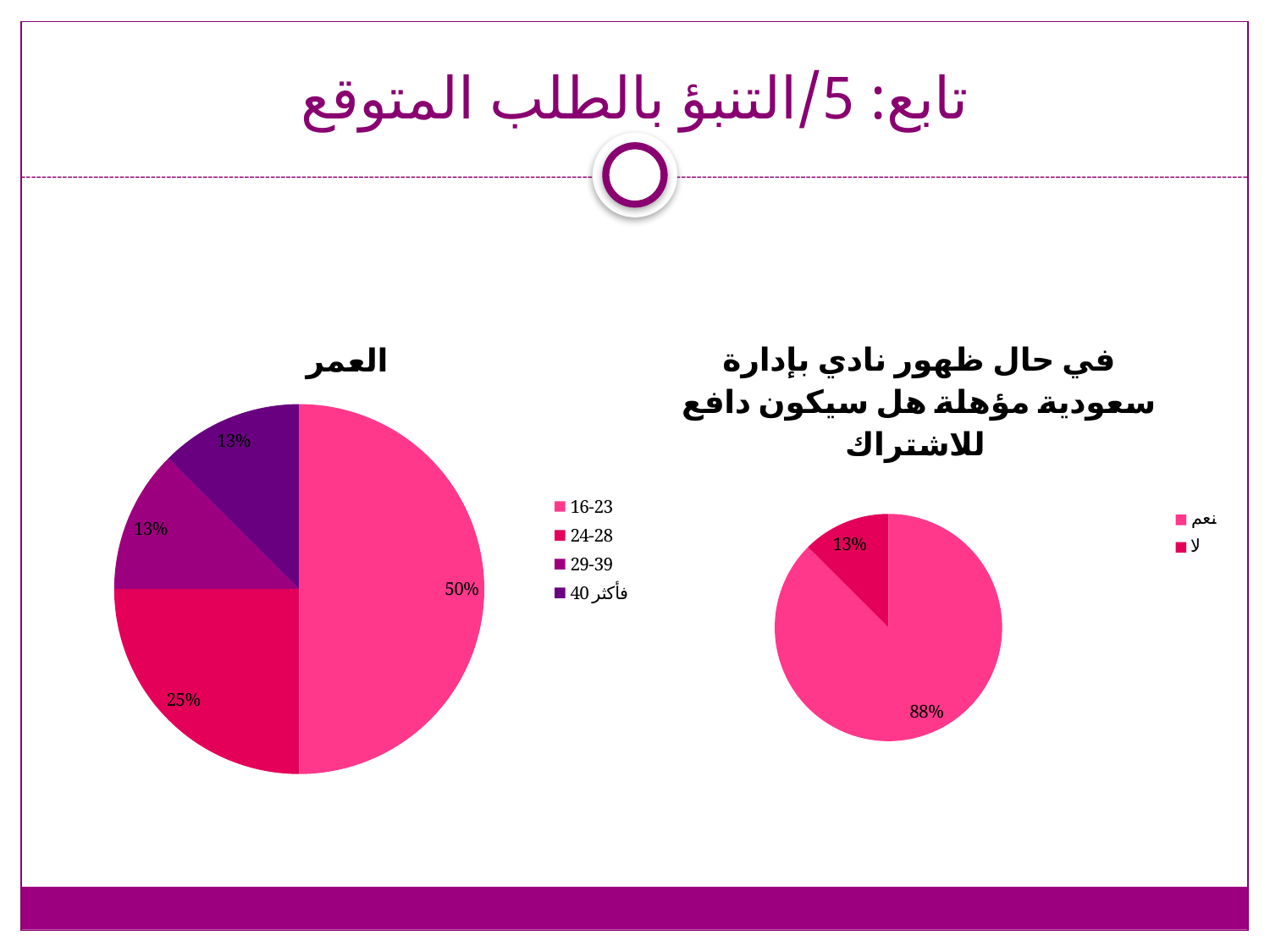
In the right-hand chart (في حال ظهور نادي بإدارة سعودية مؤهلة هل سيكون دافع للاشتراك), what share of the pie is "نعم"? 88% How many pie charts are shown on the slide? 2 In the right-hand chart (في حال ظهور نادي بإدارة سعودية مؤهلة هل سيكون دافع للاشتراك), what is the value for "لا"? 13% In the chart titled "العمر", which is larger, the 24-28 share or the 29-39 share? 24-28 In the chart titled "العمر", what is the difference between the 16-23 share and the 24-28 share? 25% In the chart titled "العمر", what share of the pie is the 16-23 category? 50% What kind of chart is the chart titled "العمر"? Pie chart In the chart titled "العمر", how many categories does the legend list? 4 In the chart titled "العمر", what is the value for the 24-28 category? 25% In the chart titled "العمر", which age category has the largest share? 16-23 In the right-hand chart (في حال ظهور نادي بإدارة سعودية مؤهلة هل سيكون دافع للاشتراك), which category has the largest share? نعم In the chart titled "العمر", what is the value for the 29-39 category? 13%